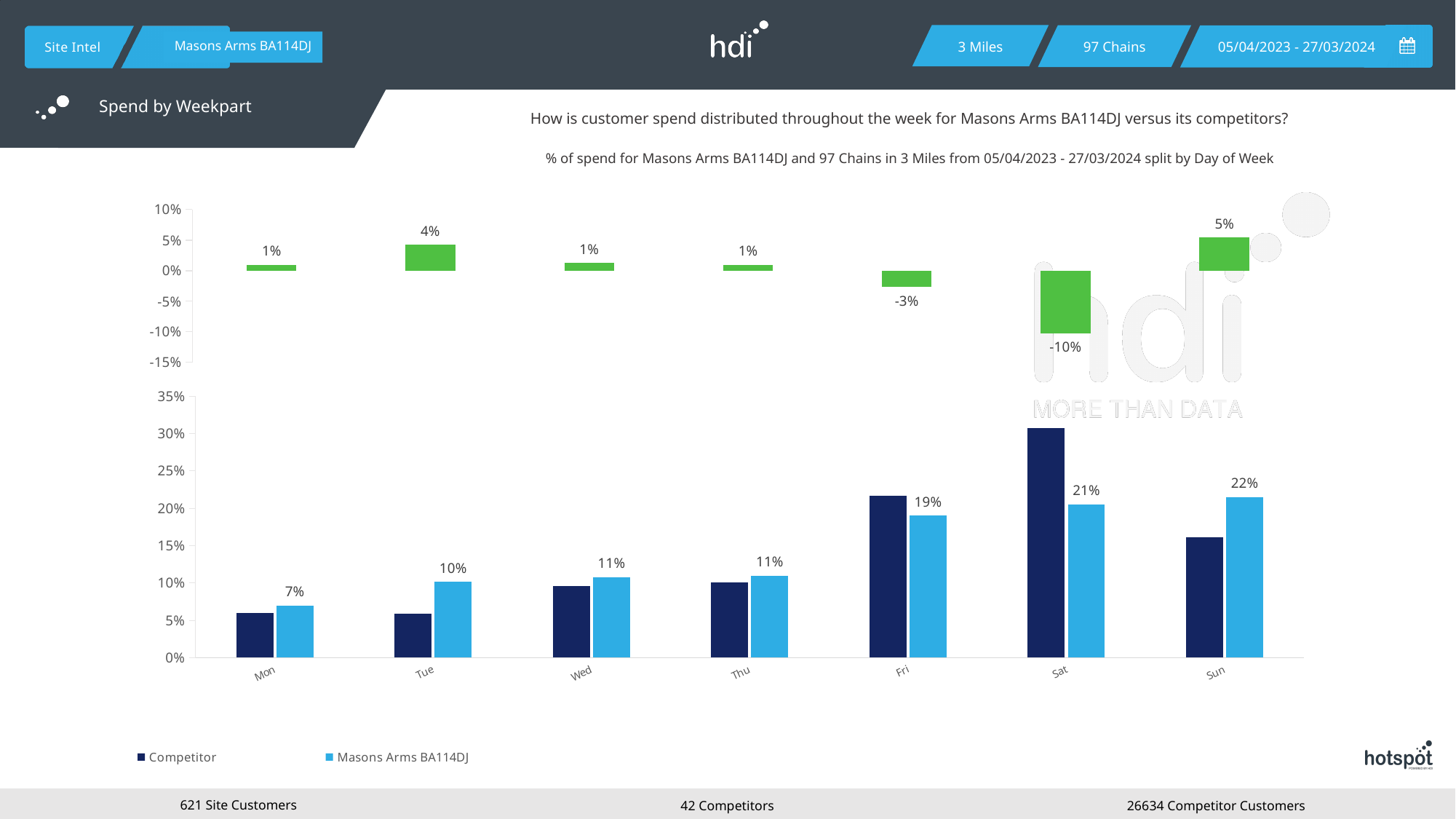
How many series does the legend of the bottom bar chart list? 2 In the top chart with green bars, which day has the highest value? Sun In the top chart with green bars, what is the value for Sat? -10% In the bottom bar chart, is the Competitor value for Tue greater or less than 10%? less In the bottom bar chart, on which day is the Masons Arms BA114DJ value highest? Sun In the bottom bar chart, what is the value for Masons Arms BA114DJ on Sat? 21% In the bottom bar chart, what is the difference between the Masons Arms BA114DJ values for Sun and Mon? 15% In the bottom bar chart, what is the value for Masons Arms BA114DJ on Mon? 7% In the bottom bar chart, is the Competitor value for Sat greater or less than 25%? greater In the bottom bar chart, on which day is the Masons Arms BA114DJ value lowest? Mon In the bottom bar chart, which is larger on Sat: the Competitor value or the Masons Arms BA114DJ value? Competitor How many days of the week are shown on the x axis of the bottom bar chart? 7